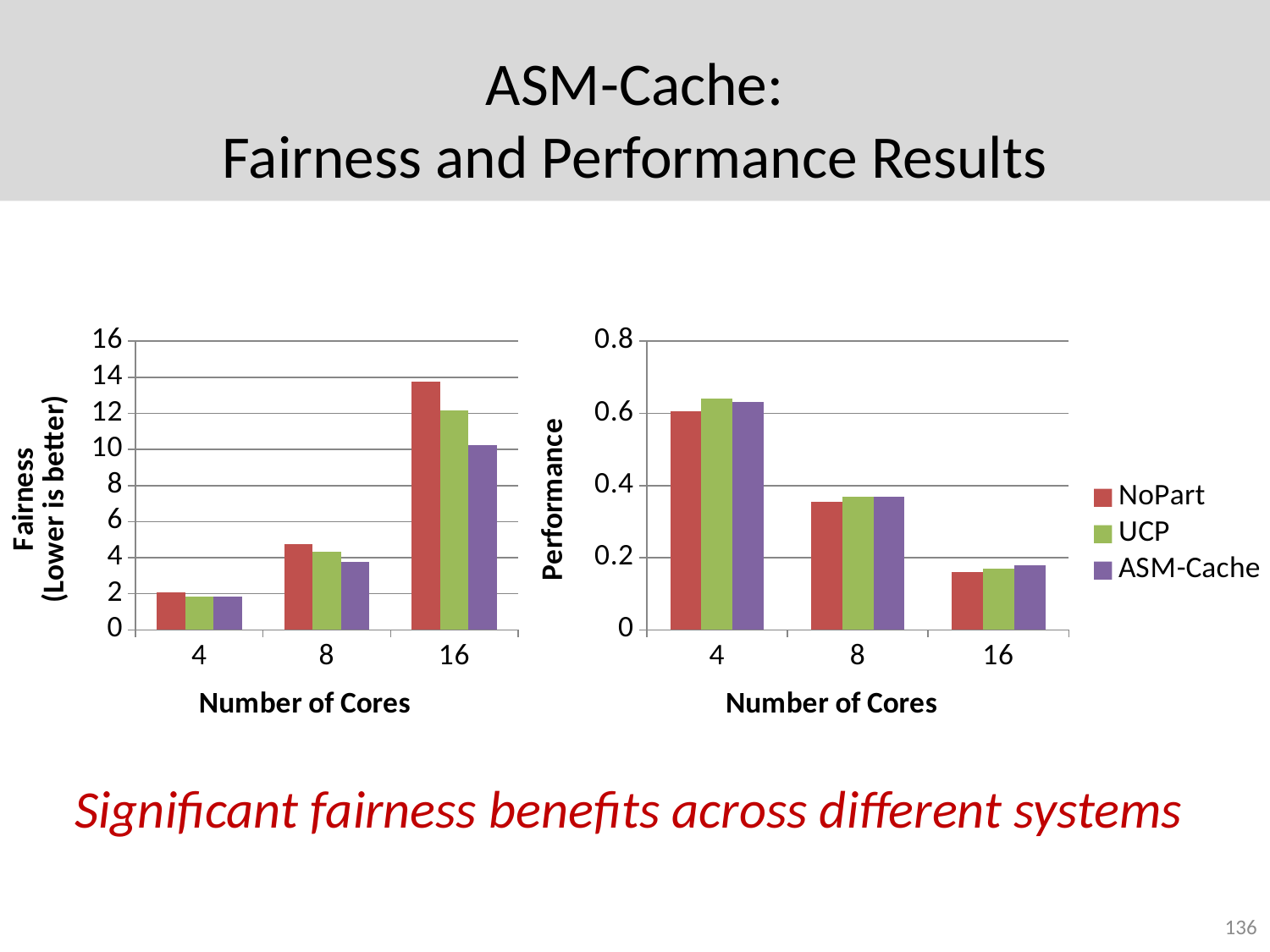
In the left chart (Fairness), at 8 cores, which is larger: UCP or ASM-Cache? UCP How many series does the legend list? 3 In the right chart (Performance), is the NoPart value at 4 cores greater or less than 0.4? greater In the right chart (Performance), do the ASM-Cache values rise or fall as the number of cores increases? fall In the left chart (Fairness), at 16 cores, which is larger: NoPart or ASM-Cache? NoPart In the left chart (Fairness), at which number of cores is the NoPart value highest? 16 In the left chart (Fairness), do the NoPart values rise or fall as the number of cores increases? rise In the left chart (Fairness), is the NoPart value at 16 cores greater or less than 12? greater What kind of chart is the left chart (Fairness)? bar chart In the left chart (Fairness), how many Number of Cores categories are shown on the x axis? 3 In the right chart (Performance), is the ASM-Cache value at 16 cores greater or less than 0.2? less